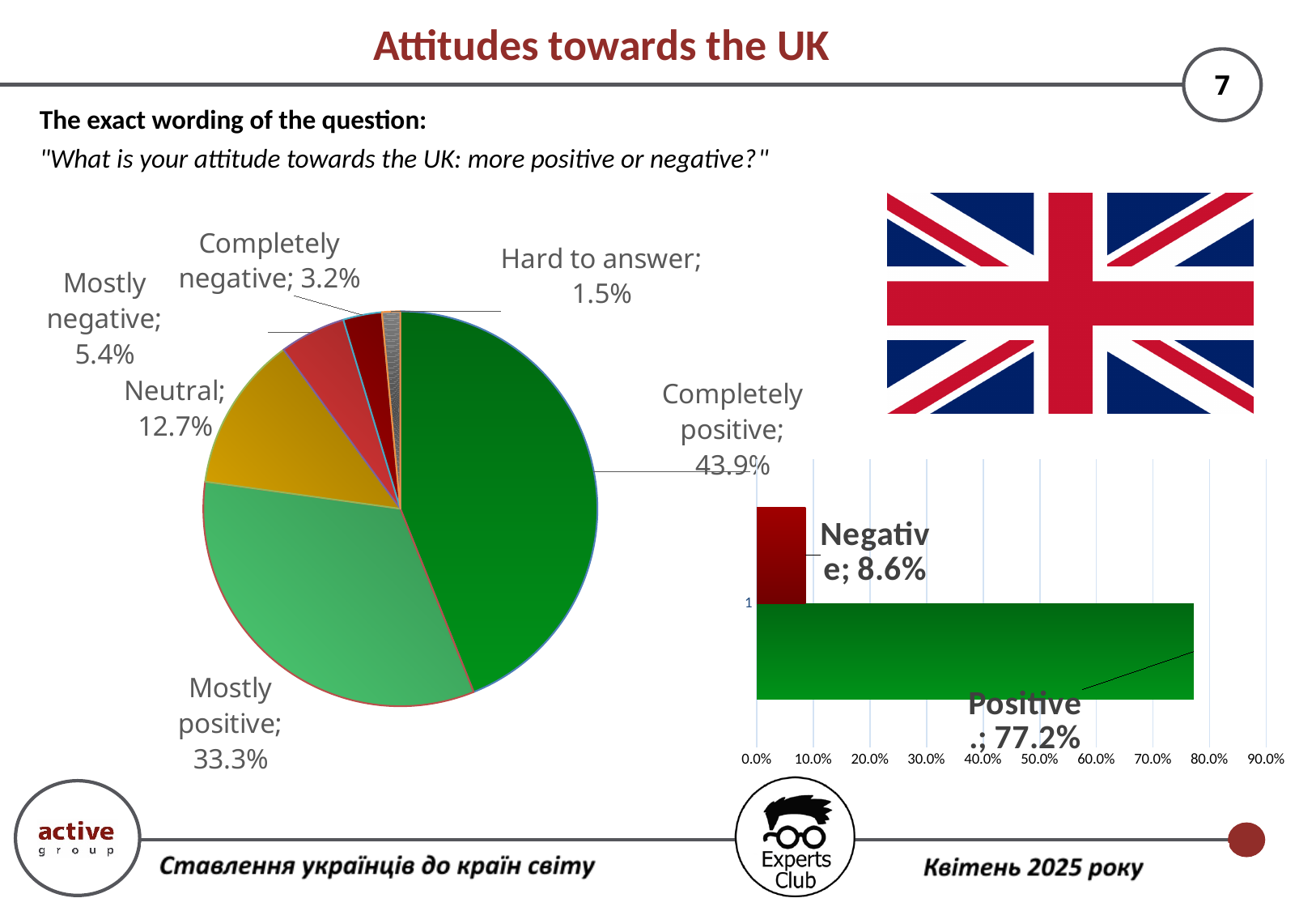
In the pie chart on the left, what share of respondents answered "Hard to answer"? 1.5% What kind of chart is shown on the right side of the slide? Bar chart In the pie chart on the left, what share of respondents answered "Completely positive"? 43.9% In the pie chart on the left, which category has the smallest share? Hard to answer In the pie chart on the left, which category has the largest share? Completely positive In the pie chart on the left, what is the difference between the "Completely positive" and "Mostly positive" shares? 10.6% In the pie chart on the left, how many categories are shown? 6 In the bar chart on the right, what is the value for "Negative"? 8.6% In the pie chart on the left, what share of respondents answered "Neutral"? 12.7% In the bar chart on the right, what is the value for "Positive"? 77.2% In the bar chart on the right, what is the difference between the "Positive" and "Negative" values? 68.6% In the pie chart on the left, which is larger: "Mostly negative" or "Completely negative"? Mostly negative